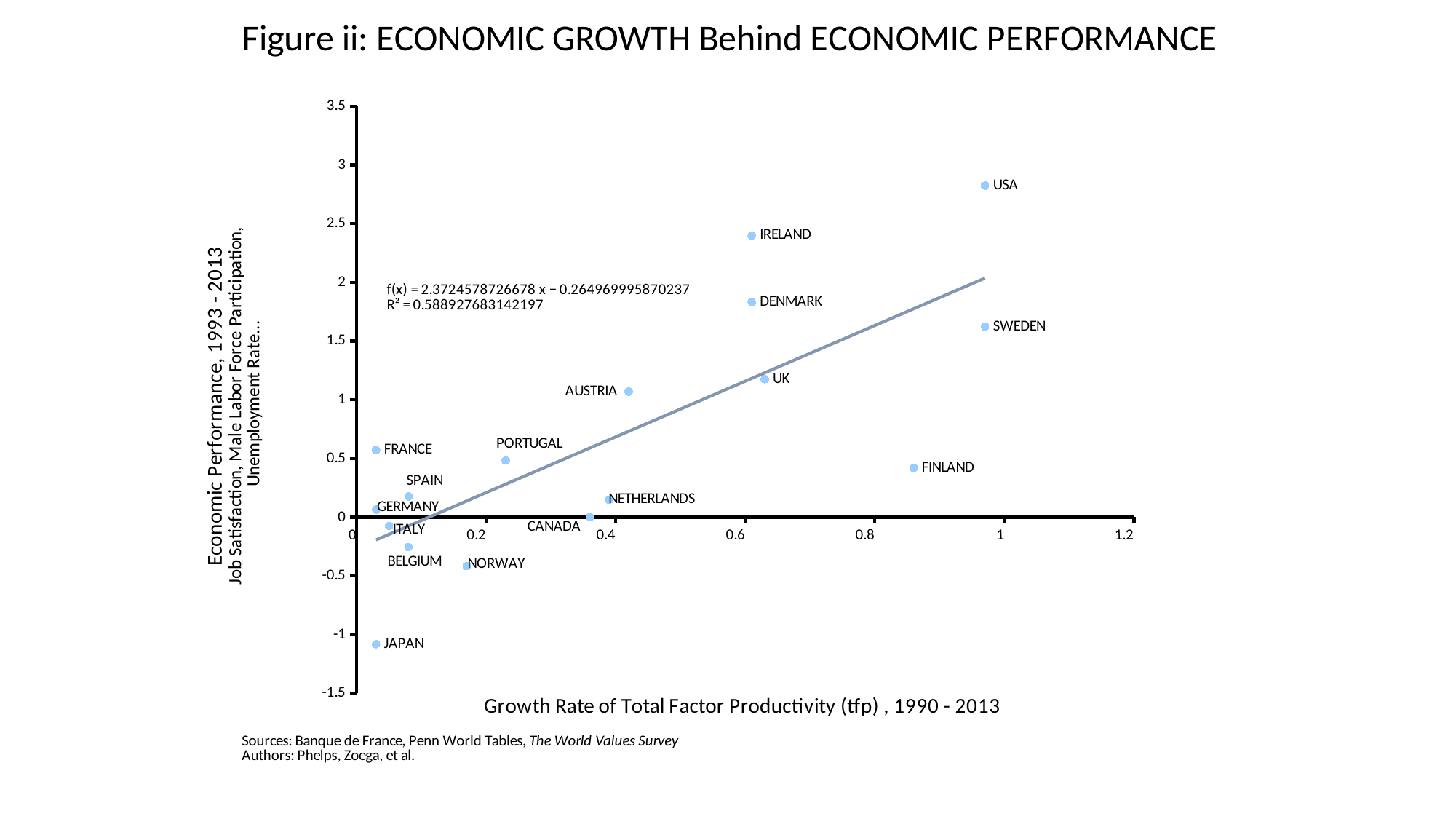
Is the economic performance value for USA greater or less than 2.5? greater What kind of chart is shown on the slide? Scatter chart Is the economic performance value for Ireland greater or less than 2? greater How many countries are plotted as points on the chart? 17 What R² value is printed on the chart for the fitted line? 0.588927683142197 Which country has the lowest economic performance value on the chart? Japan Is the growth rate of total factor productivity for Finland greater or less than 0.8? greater Does the fitted trend line rise or fall as the growth rate of total factor productivity increases? Rises Which has the higher economic performance value, Norway or Japan? Norway Which country has the highest economic performance value on the chart? USA Which has the higher economic performance value, Ireland or Denmark? Ireland